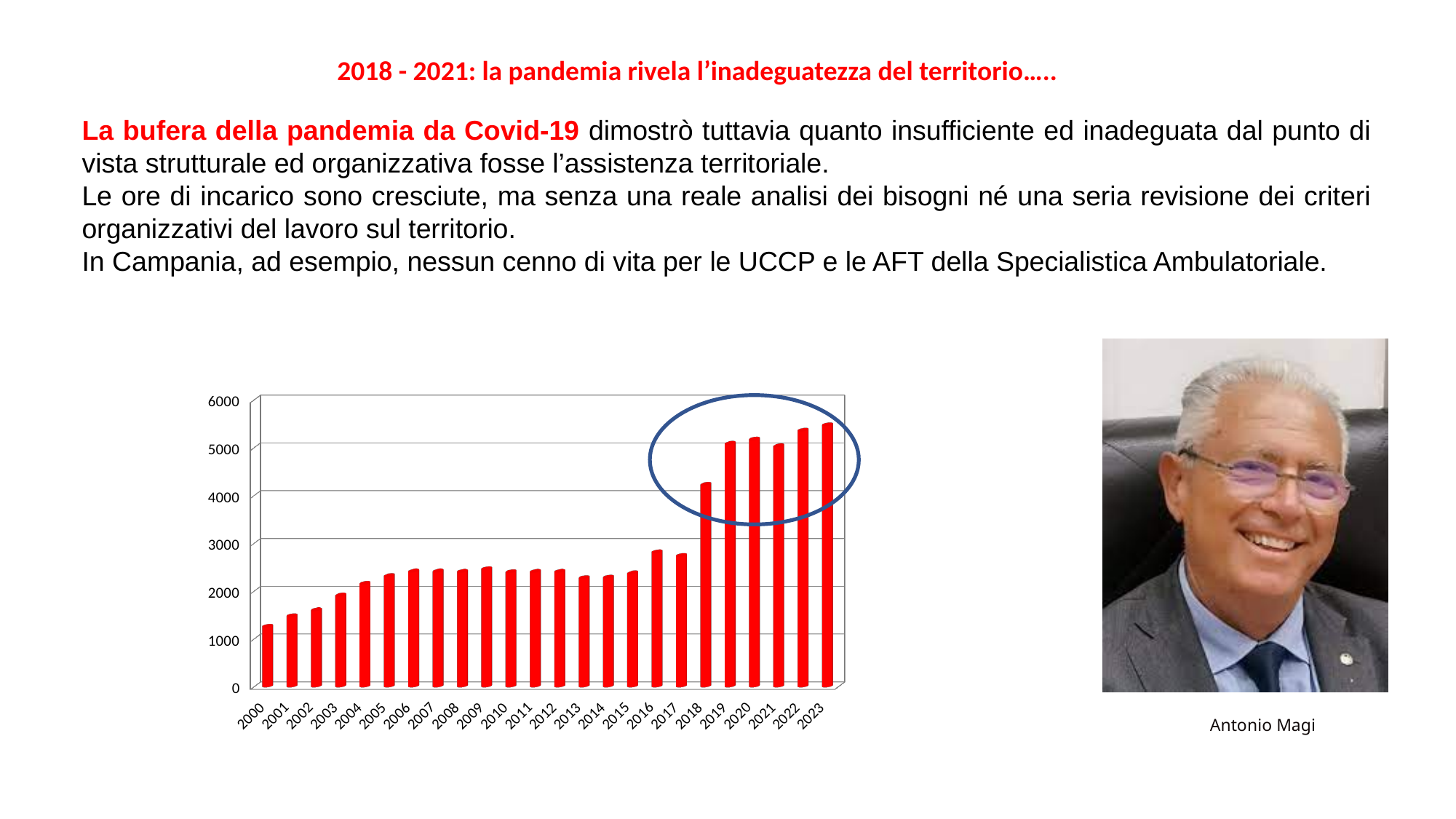
What colour are the bars on the chart? Red Is the value for 2017 greater or less than 3000? less Which year has the lowest bar on the chart? 2000 Which year has the highest bar on the chart? 2023 Is the value for 2018 greater or less than 4000? greater How many years (bars) are plotted on the chart? 24 Overall, do the values rise or fall from 2000 to 2023? Rise What kind of chart is shown on the slide? Bar chart Which year has the larger value, 2017 or 2018? 2018 Is the value for 2000 greater or less than 1000? greater